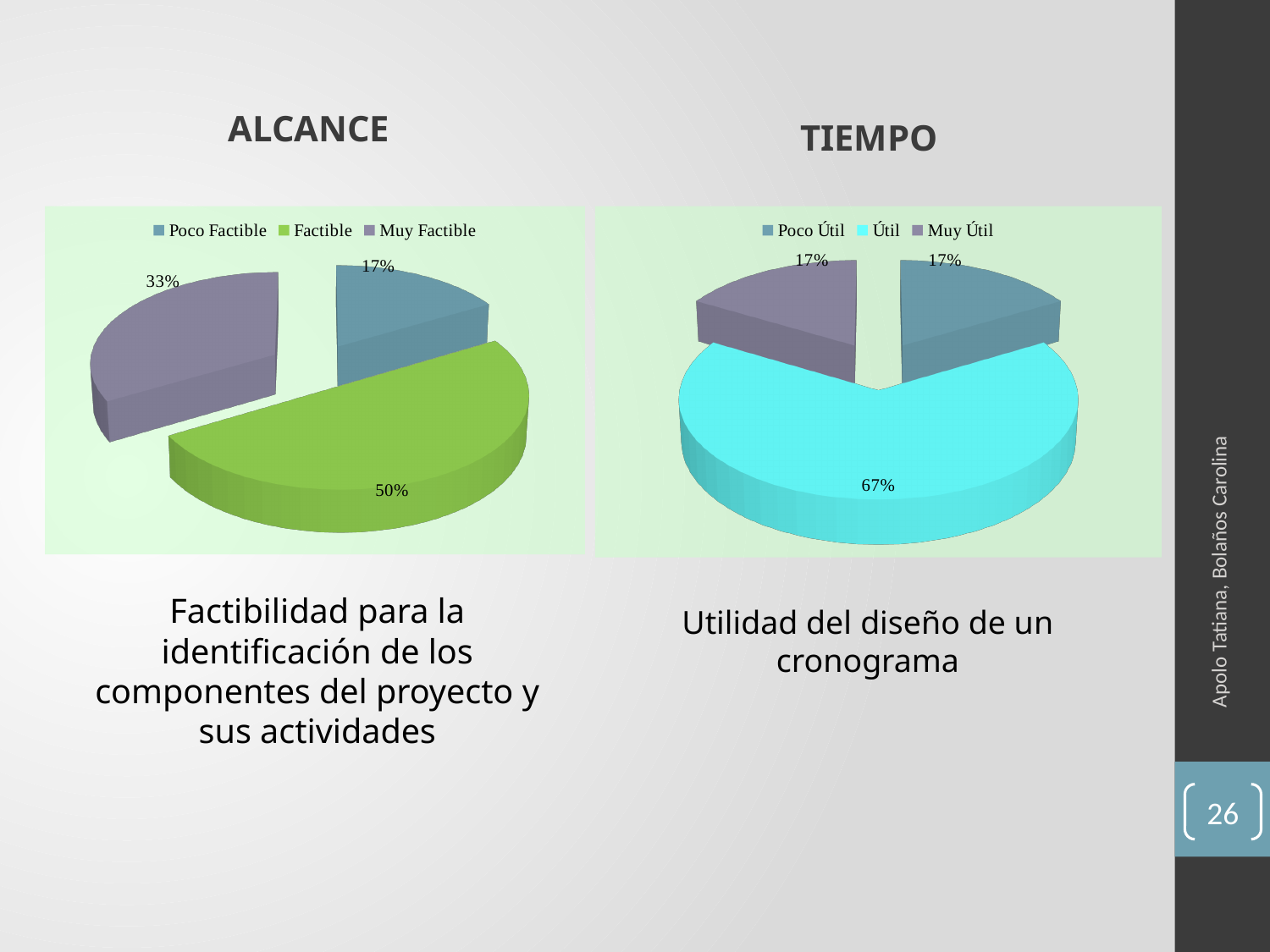
In the ALCANCE chart, what share does Muy Factible have? 33% In the ALCANCE chart, what share does Factible have? 50% What type of chart is the ALCANCE chart? Pie chart In the ALCANCE chart, which category has the smallest share? Poco Factible In the TIEMPO chart, what share does Útil have? 67% In the TIEMPO chart, which category has the largest share? Útil In the TIEMPO chart, is the share for Útil larger or smaller than the share for Poco Útil? Larger In the TIEMPO chart, how many categories does the legend list? 3 In the ALCANCE chart, what is the difference between the shares of Factible and Muy Factible? 17% In the ALCANCE chart, what share does Poco Factible have? 17% In the ALCANCE chart, which category has the largest share? Factible In the TIEMPO chart, what share does Muy Útil have? 17%